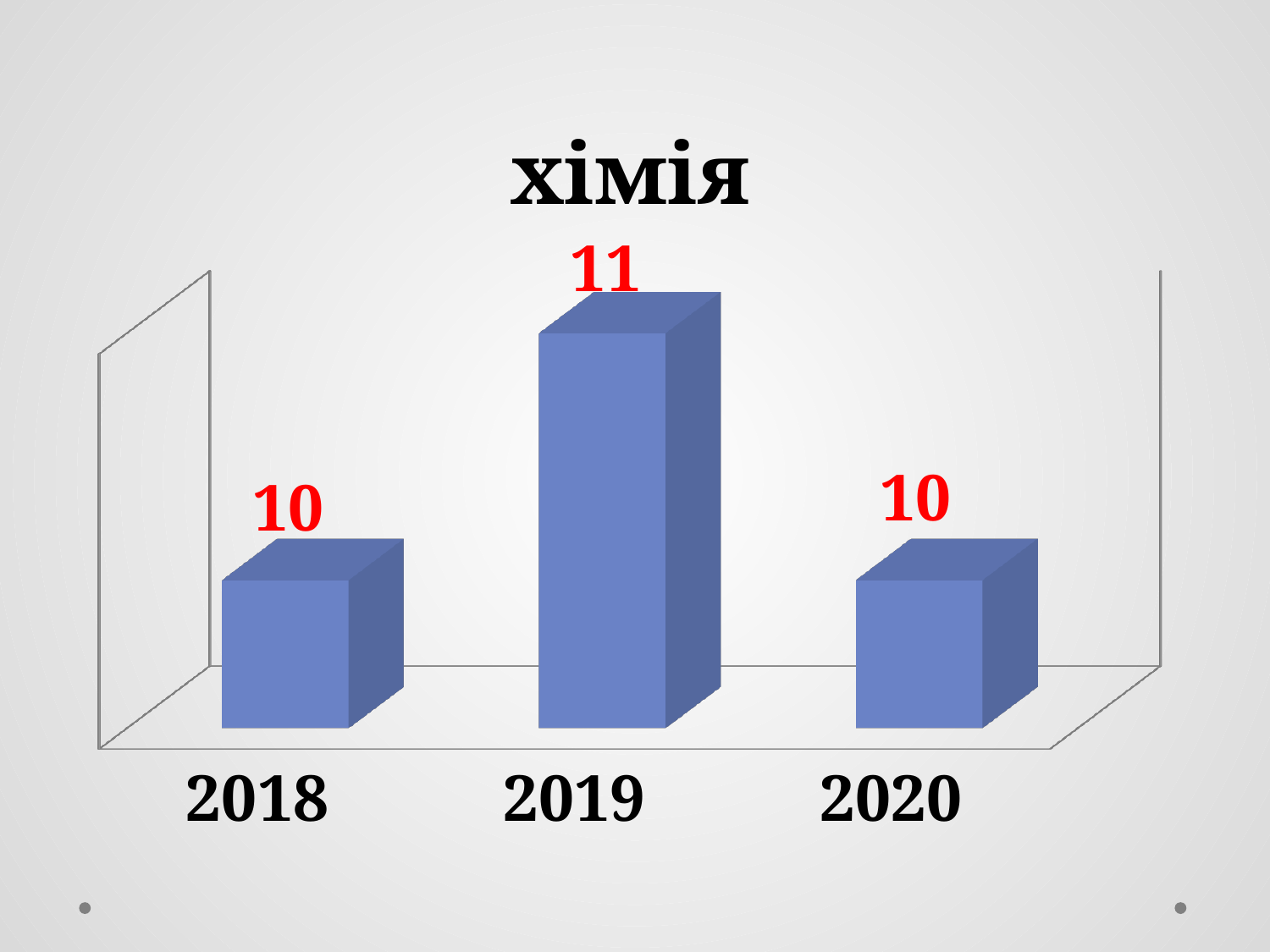
What kind of chart is shown on the slide? bar chart What is the value for 2018? 10 How many years are shown on the chart? 3 Which is larger, the value for 2019 or the value for 2020? 2019 What colour are the bars in the chart? blue Which year has the highest value? 2019 What is the difference between the values for 2019 and 2018? 1 What is the value for 2019? 11 Do the values for 2018 and 2020 differ? No, both are 10 What is the value for 2020? 10 What is the title of the chart? хімія